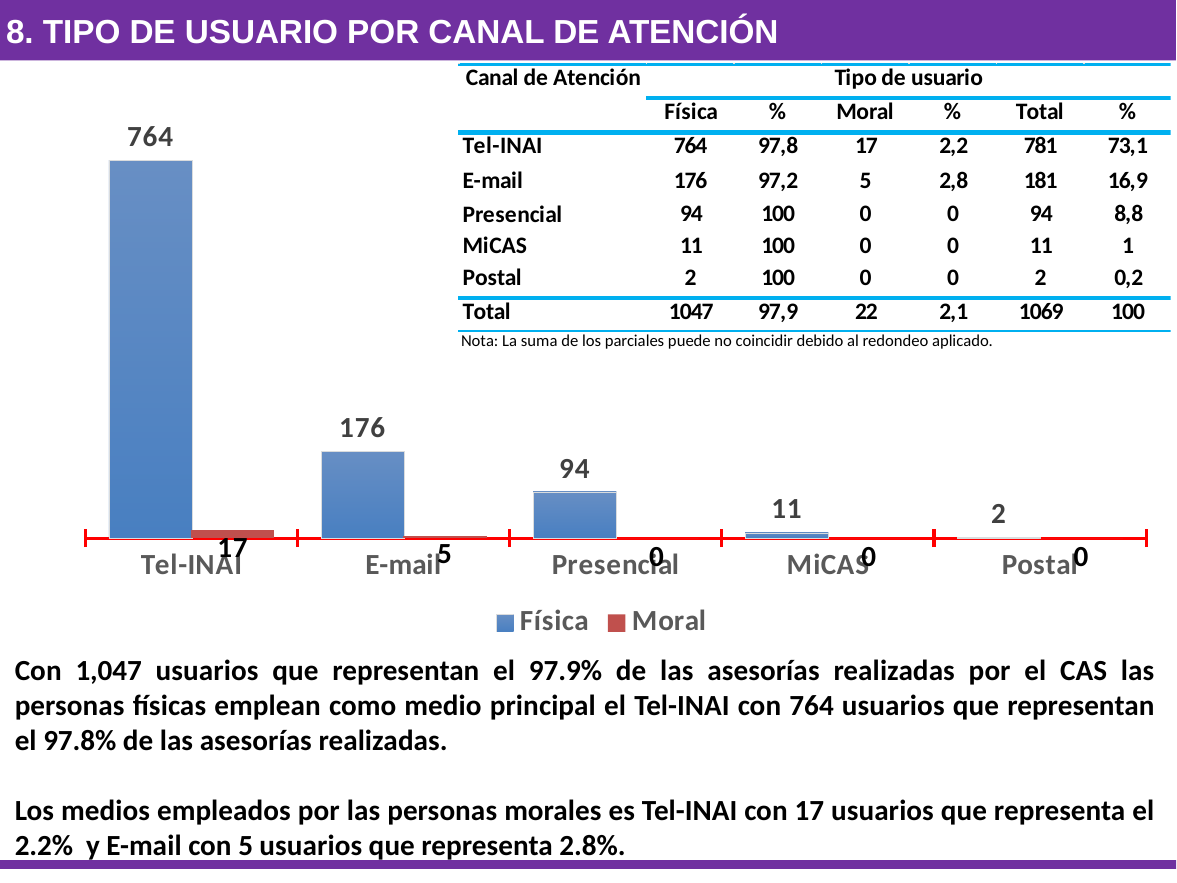
What is the difference between the Física values for Tel-INAI and E-mail? 588 What is the Moral value for E-mail in the chart? 5 What kind of chart is shown on the slide? bar chart Which series is shown in red in the chart? Moral What is the Física value for Presencial in the chart? 94 Which channel has the lowest Física value in the chart? Postal Which channel has the highest Física value in the chart? Tel-INAI How many series does the chart legend list? 2 What is the Física value for Tel-INAI in the chart? 764 Which is larger, the Física value for E-mail or for Presencial? E-mail What is the Moral value for Tel-INAI in the chart? 17 How many channels (categories) are shown on the x axis of the chart? 5